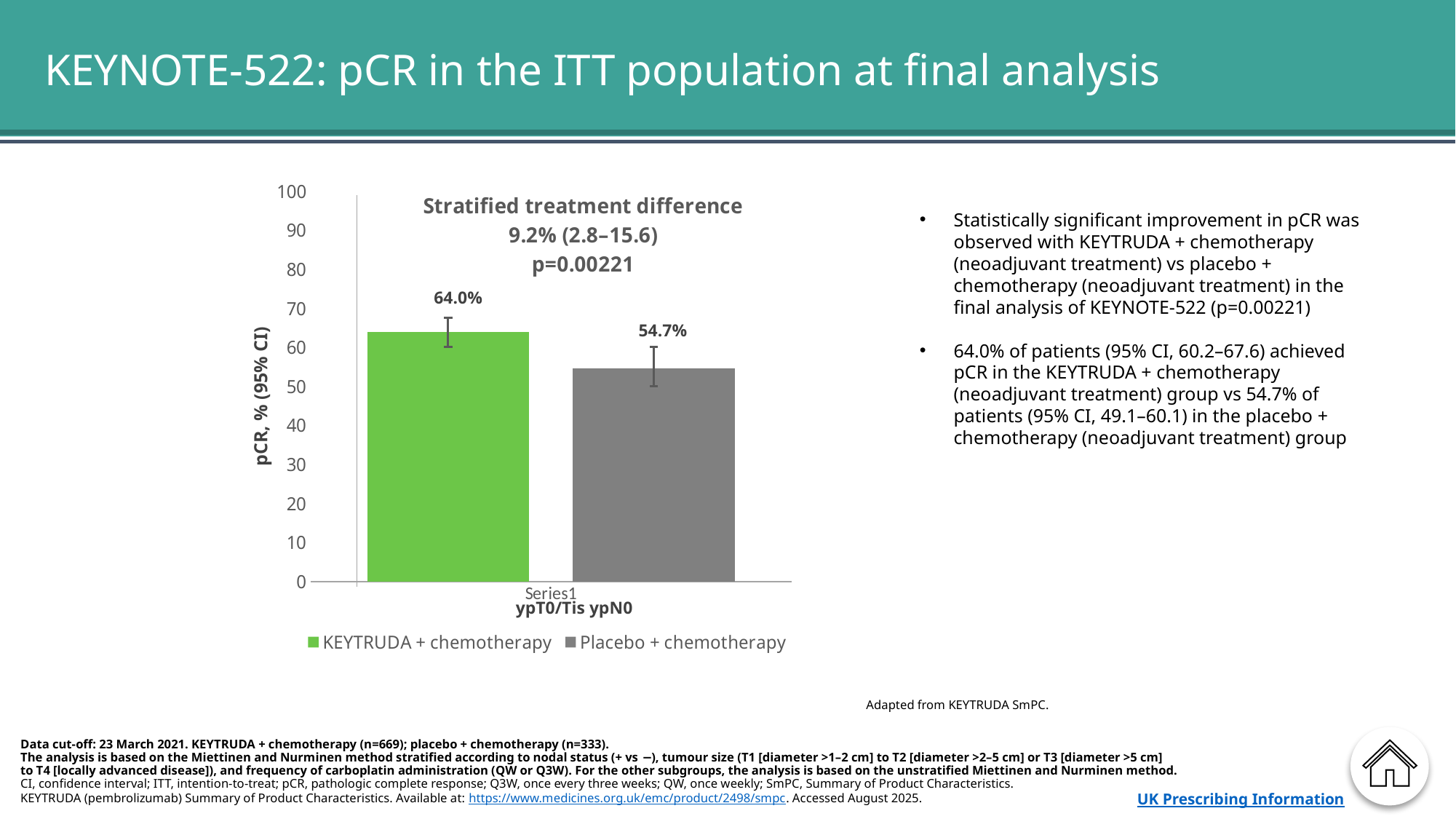
How many series does the legend list? 2 Which series has the lower pCR rate? Placebo + chemotherapy What is the difference between the pCR rates for KEYTRUDA + chemotherapy and Placebo + chemotherapy? 9.3% What is the pCR rate for KEYTRUDA + chemotherapy? 64.0% Is the pCR rate for Placebo + chemotherapy greater or less than 60? less What kind of chart is shown on the slide? Bar chart Which series has the higher pCR rate? KEYTRUDA + chemotherapy Is the pCR rate for KEYTRUDA + chemotherapy larger or smaller than that for Placebo + chemotherapy? larger What stratified treatment difference is printed above the bars? 9.2% (2.8–15.6) Is the pCR rate for KEYTRUDA + chemotherapy greater or less than 60? greater What is the pCR rate for Placebo + chemotherapy? 54.7% What is the label of the y axis? pCR, % (95% CI)